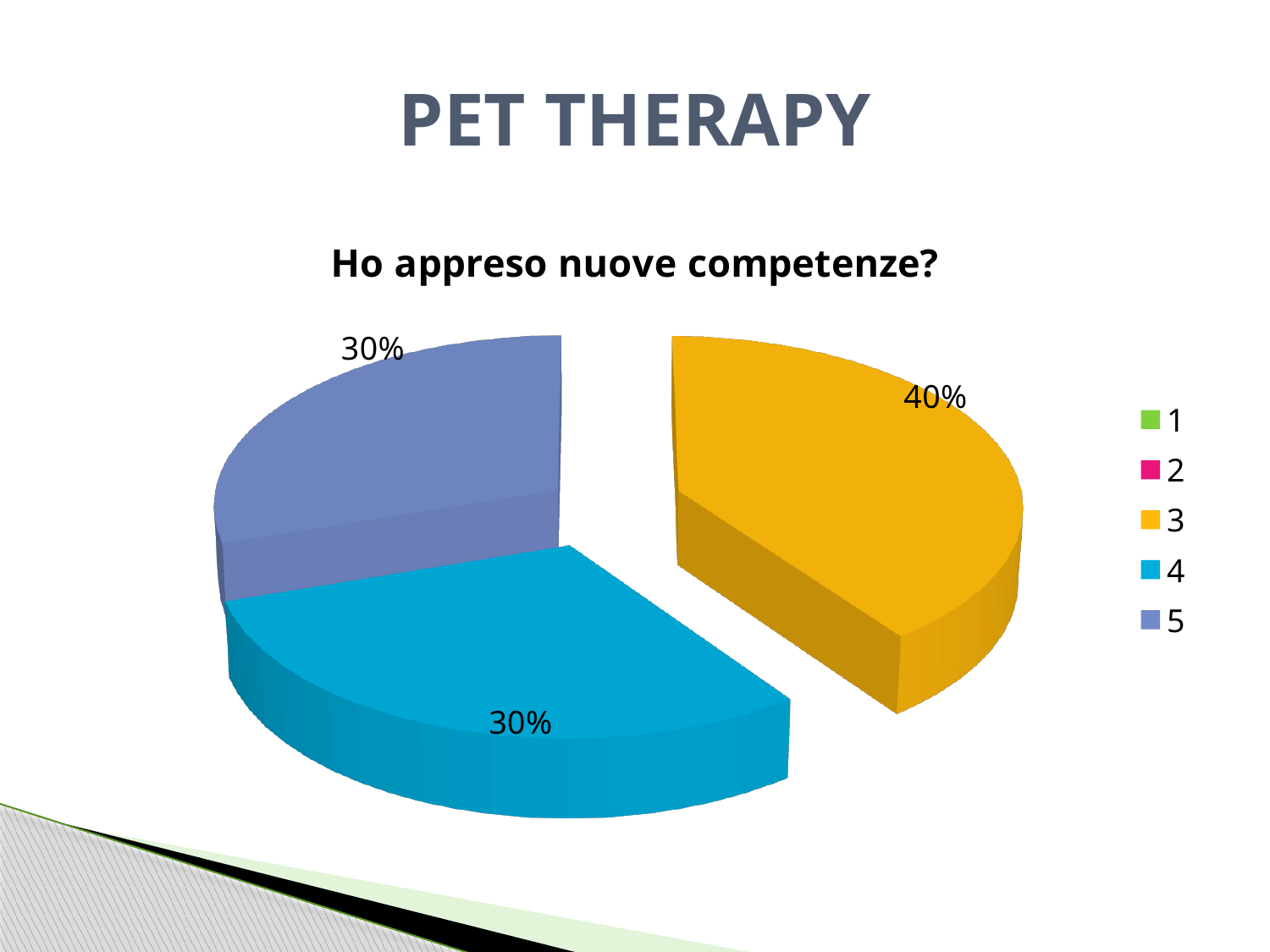
Which category has the largest slice of the pie? 3 How many slices are visible in the pie chart? 3 What share of the pie does category 5 have? 30% How many entries does the chart legend list? 5 What kind of chart is shown on the slide? pie chart What colour is the slice for category 3? yellow What is the title of the chart? Ho appreso nuove competenze? What is the combined share of categories 4 and 5? 60% What is the difference in percentage points between the slice for category 3 and the slice for category 5? 10% Which is larger, the slice for category 3 or the slice for category 4? 3 What share of the pie does category 3 have? 40% What share of the pie does category 4 have? 30%